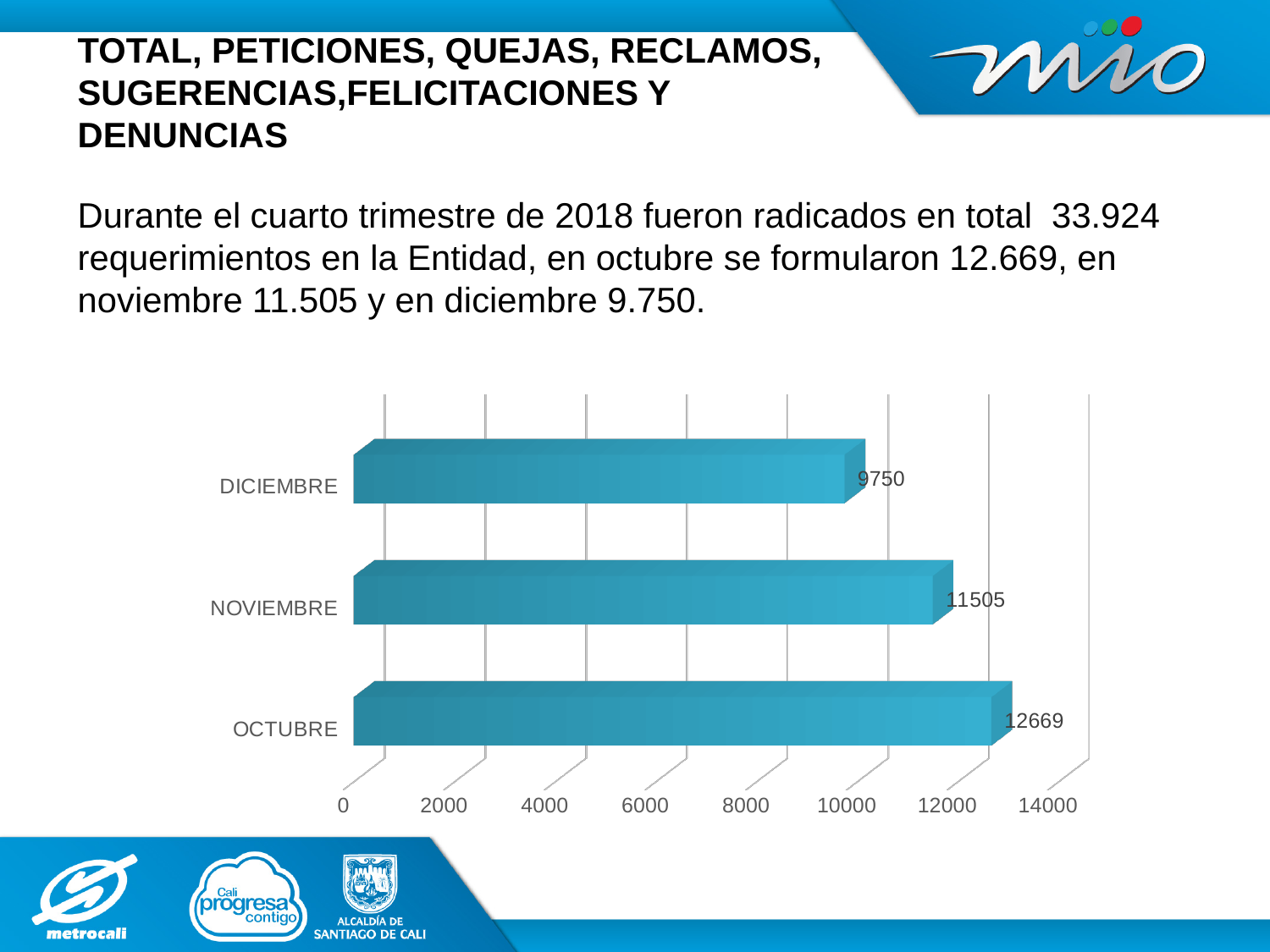
What kind of chart is shown on the slide? bar chart What is the difference between the values for OCTUBRE and NOVIEMBRE? 1164 Which month has the highest value? OCTUBRE How many months are shown in the chart? 3 What is the value for NOVIEMBRE? 11505 Which is larger, the value for NOVIEMBRE or the value for DICIEMBRE? NOVIEMBRE What is the value for DICIEMBRE? 9750 What is the value for OCTUBRE? 12669 What is the highest tick value shown on the horizontal axis? 14000 Which month has the lowest value? DICIEMBRE What is the difference between the values for NOVIEMBRE and DICIEMBRE? 1755 Is the value for DICIEMBRE greater or less than 10000? less